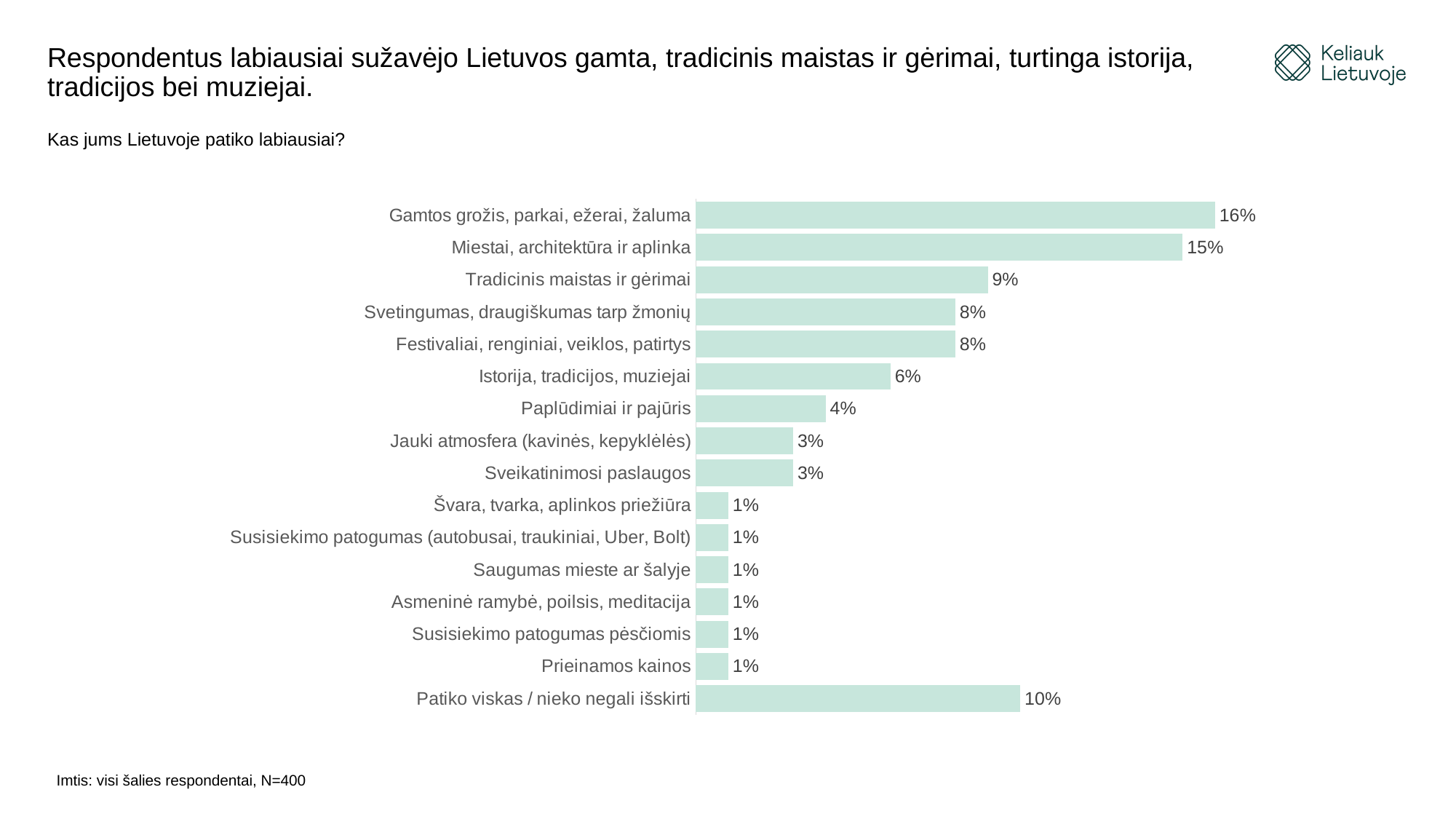
Which is larger: "Patiko viskas / nieko negali išskirti" or "Tradicinis maistas ir gėrimai"? Patiko viskas / nieko negali išskirti What kind of chart is shown on the slide? Bar chart Which category has the highest value? Gamtos grožis, parkai, ežerai, žaluma What is the value for "Patiko viskas / nieko negali išskirti"? 10% How many categories are shown in the chart? 16 What is the difference between "Istorija, tradicijos, muziejai" and "Jauki atmosfera (kavinės, kepyklėlės)"? 3% What question is the chart based on, as shown above the chart? Kas jums Lietuvoje patiko labiausiai? What is the value for "Tradicinis maistas ir gėrimai"? 9% What is the difference between "Gamtos grožis, parkai, ežerai, žaluma" and "Miestai, architektūra ir aplinka"? 1% What is the value for "Paplūdimiai ir pajūris"? 4% What percentage of respondents chose "Gamtos grožis, parkai, ežerai, žaluma"? 16% How many categories have a value of 1%? 6